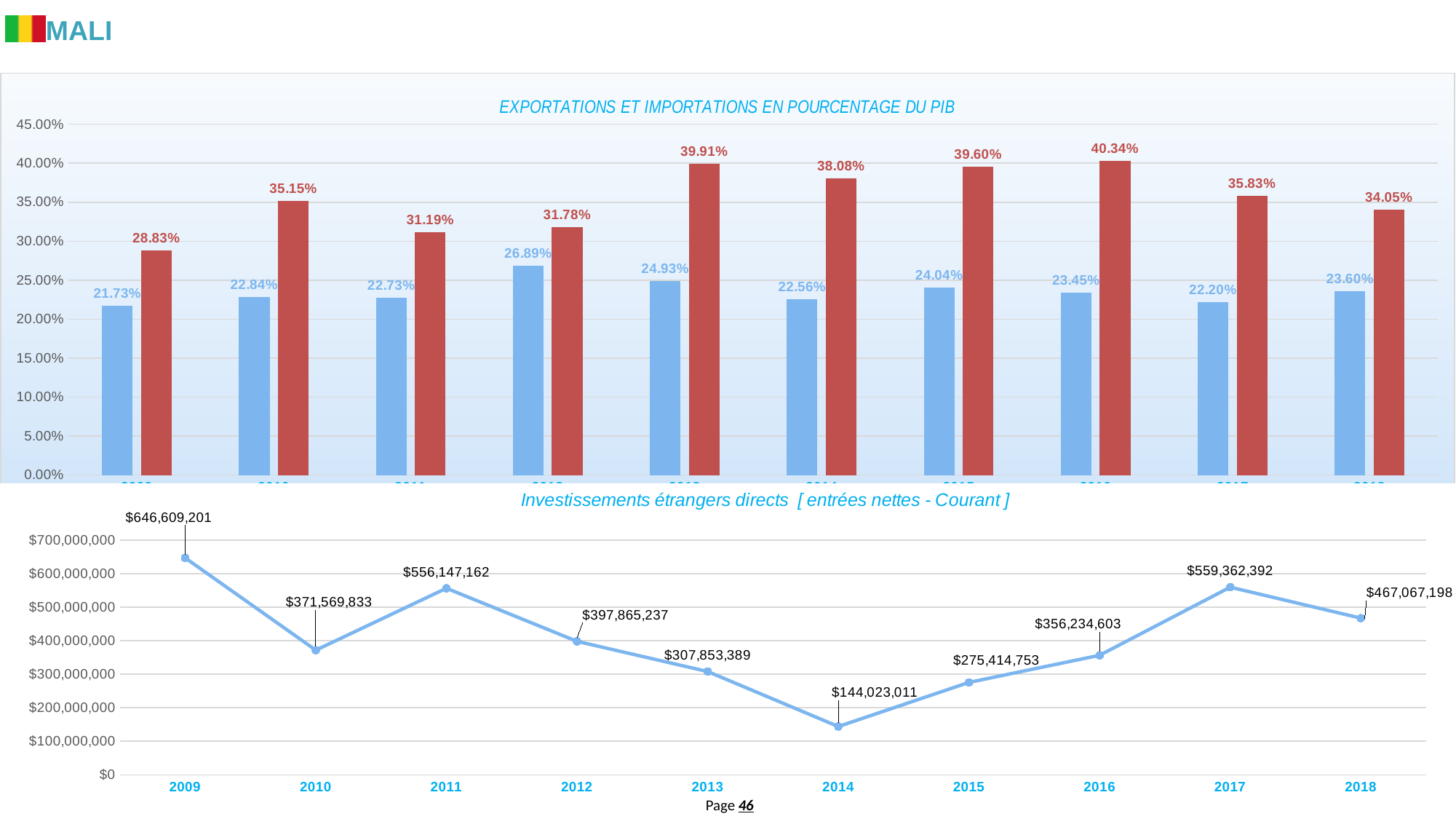
In the bottom chart (Investissements étrangers directs), how many data points are plotted? 10 In the bottom chart (Investissements étrangers directs), which year has the highest value? 2009 In the bottom chart (Investissements étrangers directs), does the value rise or fall from 2009 to 2010? fall In the bottom chart (Investissements étrangers directs), which year has the lowest value? 2014 In the top chart (Exportations et importations en pourcentage du PIB), what is the highest value among the red bars? 40.34% In the bottom chart (Investissements étrangers directs), which year has the larger value, 2011 or 2018? 2011 In the top chart (Exportations et importations en pourcentage du PIB), what is the lowest value among the blue bars? 21.73% In the bottom chart (Investissements étrangers directs), what is the difference between the 2017 value and the 2016 value? $203,127,789 What kind of chart is the top chart (Exportations et importations en pourcentage du PIB)? bar chart In the bottom chart (Investissements étrangers directs), what is the value for 2014? $144,023,011 What kind of chart is the bottom chart (Investissements étrangers directs)? line chart In the bottom chart (Investissements étrangers directs), what is the value for 2012? $397,865,237